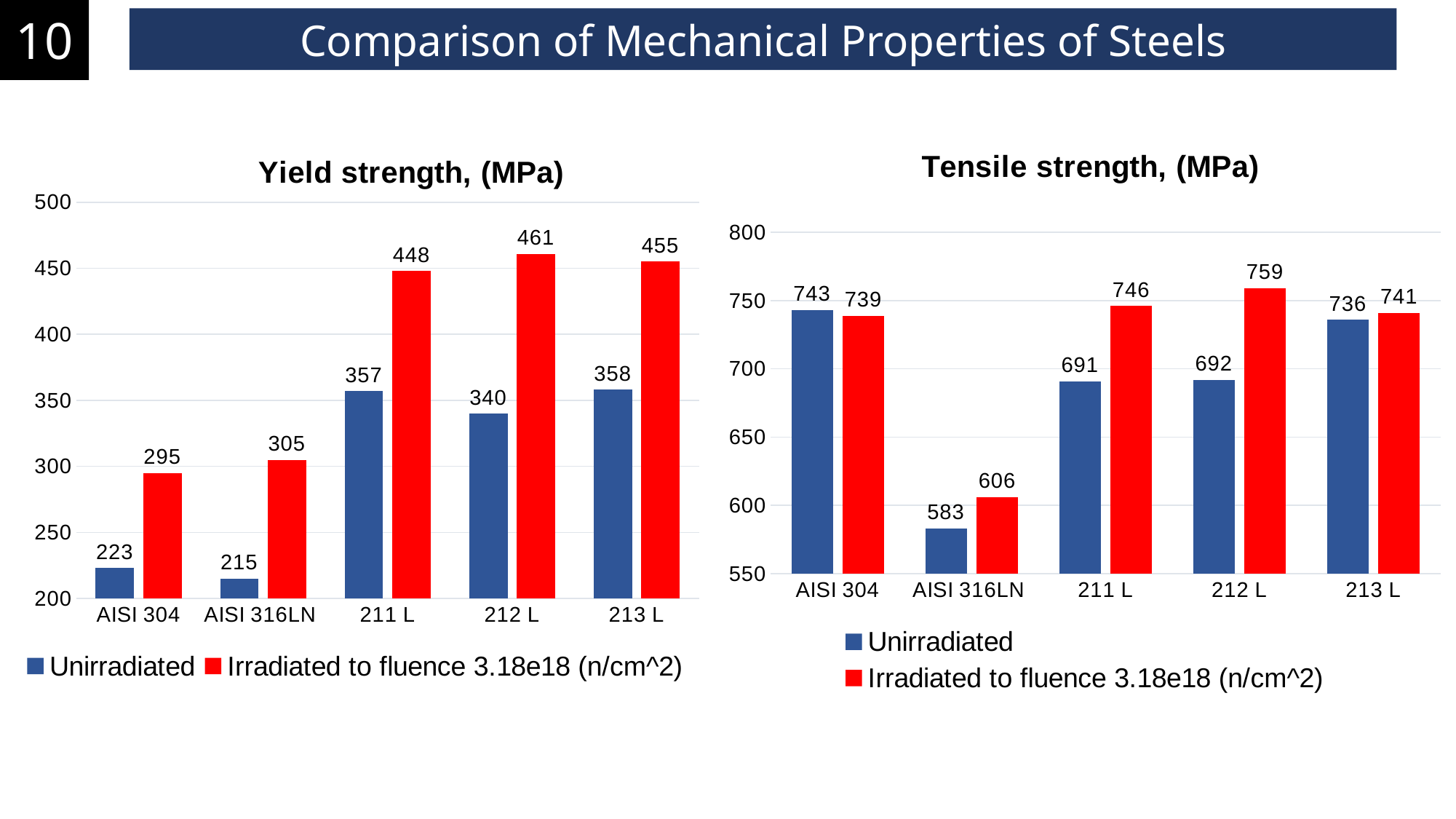
In the Yield strength chart, which category has the lowest Unirradiated value? AISI 316LN In the Yield strength chart, what is the Unirradiated value for AISI 304? 223 In the Yield strength chart, what is the difference between the Irradiated and Unirradiated values for 211 L? 91 In the Tensile strength chart, which category has the highest Irradiated to fluence 3.18e18 (n/cm^2) value? 212 L How many series does the legend of the Tensile strength chart list? 2 In the Tensile strength chart, what is the Irradiated to fluence 3.18e18 (n/cm^2) value for 211 L? 746 In the Tensile strength chart, what is the difference between the Irradiated and Unirradiated values for AISI 316LN? 23 How many categories are shown on the x axis of the Yield strength chart? 5 In the Tensile strength chart, which is larger for AISI 304: the Unirradiated value or the Irradiated value? Unirradiated What kind of chart is the Yield strength chart? Bar chart In the Yield strength chart, what is the Irradiated to fluence 3.18e18 (n/cm^2) value for 212 L? 461 In the Tensile strength chart, what is the Unirradiated value for AISI 316LN? 583